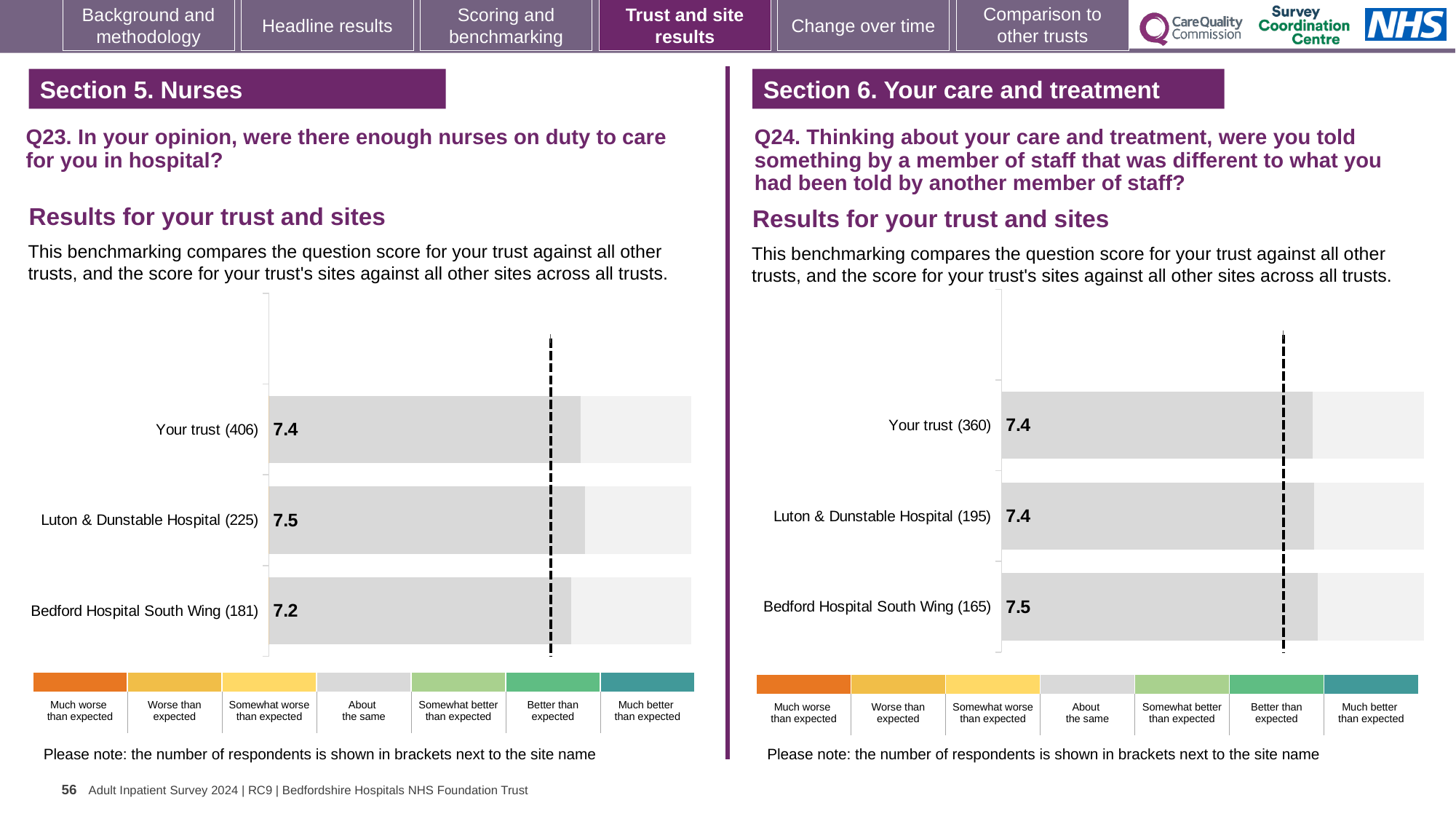
In the Q24 chart on the right, what is the score for Luton & Dunstable Hospital? 7.4 In the Q24 chart on the right, how many bars are plotted? 3 In the Q23 chart on the left, what is the score for Luton & Dunstable Hospital? 7.5 In the Q23 chart on the left, what is the score for Bedford Hospital South Wing? 7.2 What type of chart is used in the Q23 chart on the left? Bar chart In the Q23 chart on the left, which site or trust has the highest score? Luton & Dunstable Hospital In the Q23 chart on the left, how many respondents are shown for Bedford Hospital South Wing? 181 In the Q23 chart on the left, what is the difference between the scores for Luton & Dunstable Hospital and Bedford Hospital South Wing? 0.3 In the Q23 chart on the left, what is the score for Your trust? 7.4 In the Q24 chart on the right, how many respondents are shown for Your trust? 360 In the Q24 chart on the right, what is the score for Bedford Hospital South Wing? 7.5 In the Q23 chart on the left, which site or trust has the lowest score? Bedford Hospital South Wing